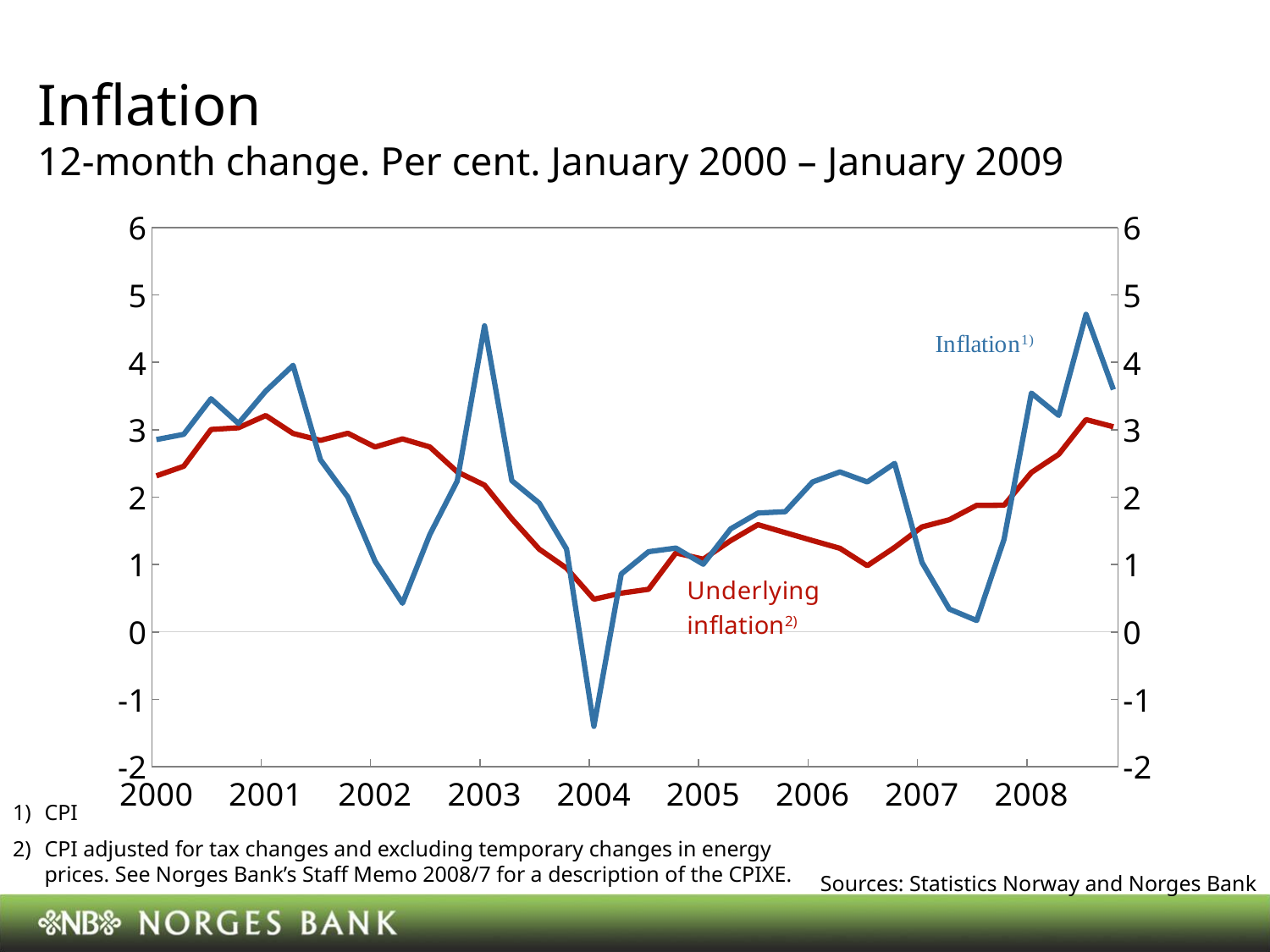
How many series are plotted on the chart? 2 At the start of 2003, which series has the higher value, Inflation or Underlying inflation? Inflation At the start of 2004, which series has the higher value, Inflation or Underlying inflation? Underlying inflation Is the value of Inflation at the start of 2003 greater or less than 4? greater Which series reaches the lowest value on the chart? Inflation Which colour is used for the Underlying inflation line? red Is the value of Underlying inflation at the start of 2004 greater or less than 0? greater Is the peak value of Inflation in 2008 greater or less than 4? greater What is the title of the chart on the slide? Inflation What kind of chart is shown on the slide? line chart Does Underlying inflation rise or fall between the start of 2001 and the start of 2004? fall